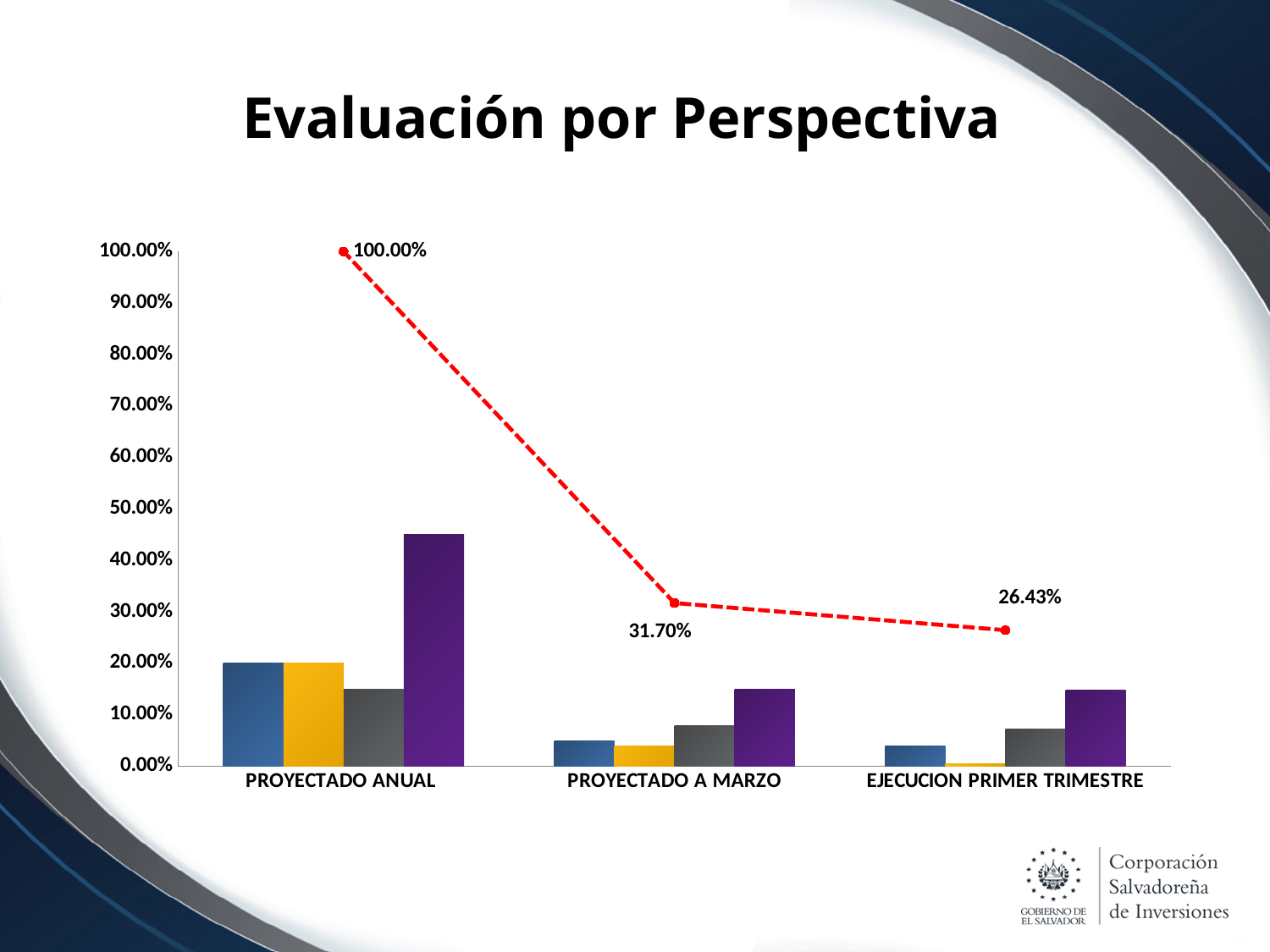
What is the difference between the line values for PROYECTADO A MARZO and EJECUCION PRIMER TRIMESTRE? 5.27% At which category does the red dashed line reach its lowest value? EJECUCION PRIMER TRIMESTRE What is the title of the chart on this slide? Evaluación por Perspectiva How many categories are shown on the x axis? 3 What is the difference between the line values for PROYECTADO ANUAL and PROYECTADO A MARZO? 68.30% What value does the red dashed line show for PROYECTADO ANUAL? 100.00% At which category does the red dashed line reach its highest value? PROYECTADO ANUAL What value does the red dashed line show for EJECUCION PRIMER TRIMESTRE? 26.43% In the PROYECTADO ANUAL group, which bar is taller, the purple bar or the blue bar? The purple bar Is the value of the purple bar for PROYECTADO ANUAL greater or less than 40.00%? greater What value does the red dashed line show for PROYECTADO A MARZO? 31.70% Does the red dashed line rise or fall from left to right across the categories? It falls